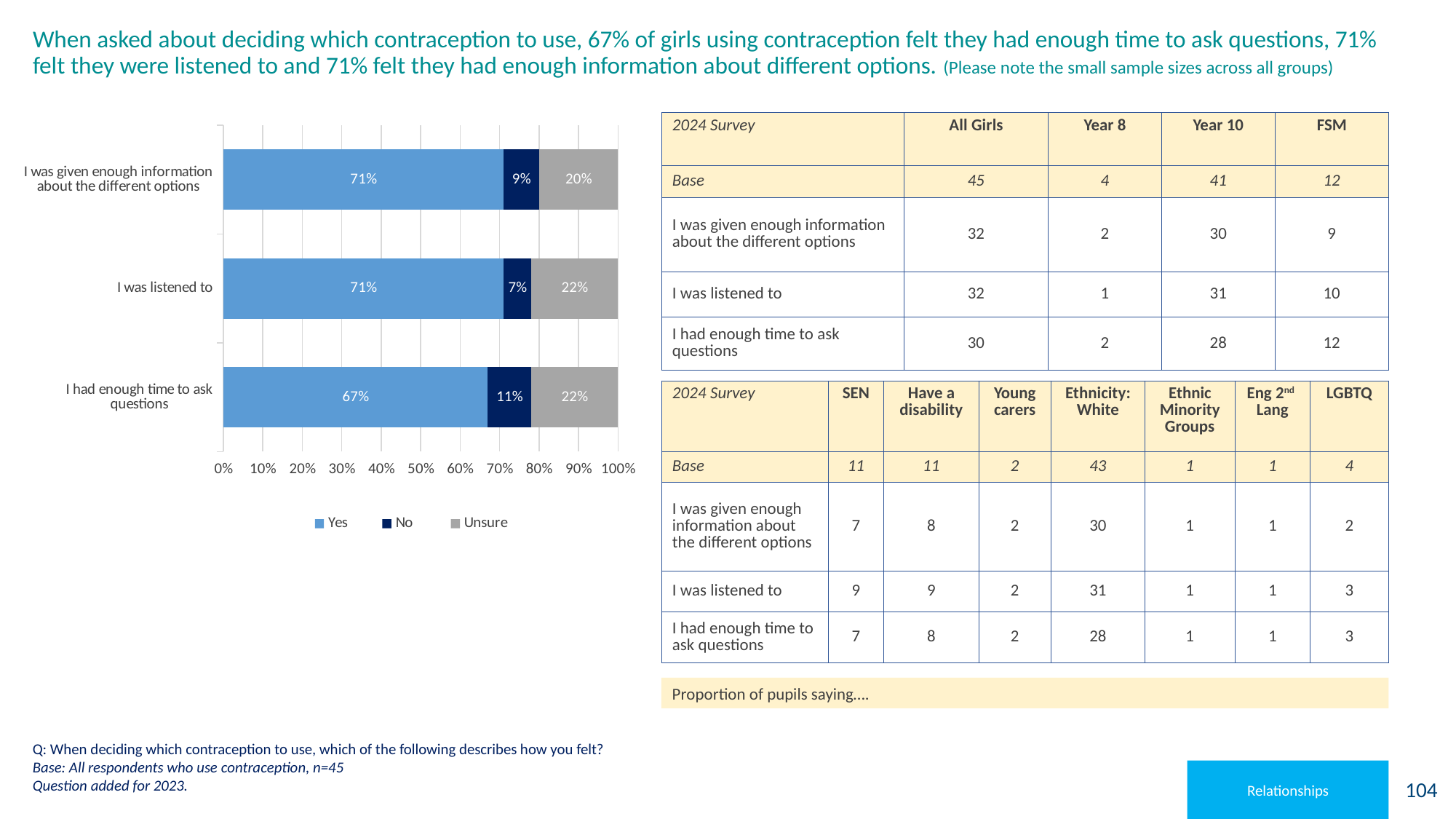
What percentage of girls were 'Unsure' about 'I had enough time to ask questions'? 22% What percentage of girls said 'No' to 'I was listened to'? 7% How many series does the chart legend list? 3 Which statement has the highest 'No' percentage? I had enough time to ask questions Is the 'Unsure' percentage larger for 'I was listened to' or for 'I was given enough information about the different options'? I was listened to What percentage of girls said 'No' to 'I had enough time to ask questions'? 11% How many statements (categories) are shown in the chart? 3 Which statement has the lowest 'Yes' percentage? I had enough time to ask questions What percentage of girls said 'Yes' to 'I was given enough information about the different options'? 71% What is the difference between the 'Yes' percentage for 'I was listened to' and the 'Yes' percentage for 'I had enough time to ask questions'? 4% Which colour represents the 'No' responses in the chart? Dark blue What type of chart is shown on the slide? Stacked bar chart